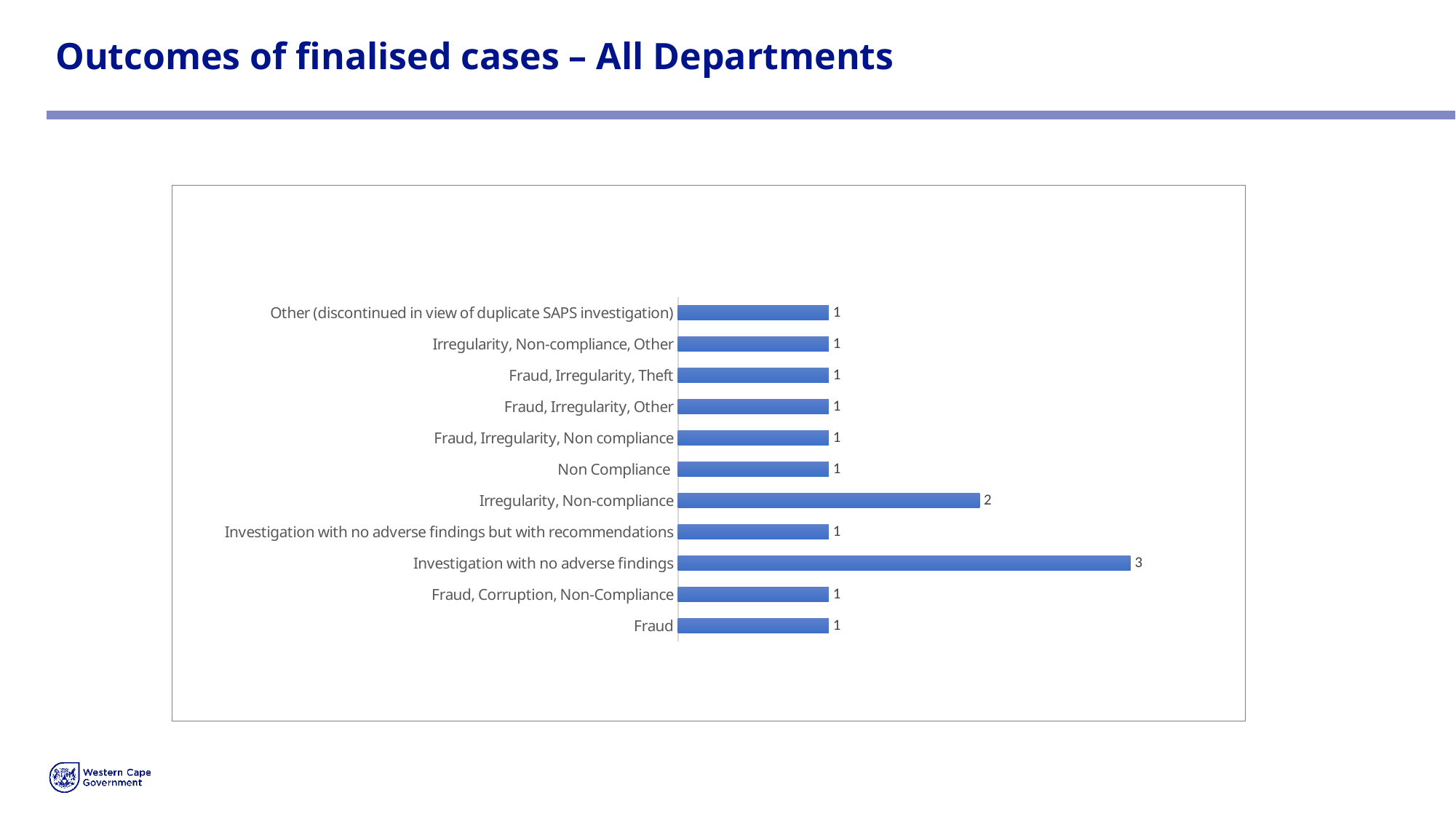
What is the value for Investigation with no adverse findings? 3 What is the title of the slide? Outcomes of finalised cases – All Departments How many categories are shown in the chart? 11 Which category has the highest value? Investigation with no adverse findings What is the total of all the values shown in the chart? 14 What is the value for Irregularity, Non-compliance? 2 What is the value for Other (discontinued in view of duplicate SAPS investigation)? 1 What kind of chart is shown on the slide? Bar chart Which is larger, the value for Irregularity, Non-compliance or the value for Non Compliance? Irregularity, Non-compliance What is the value for Fraud, Corruption, Non-Compliance? 1 What is the difference between the values for Irregularity, Non-compliance and Fraud? 1 What is the difference between the values for Investigation with no adverse findings and Irregularity, Non-compliance? 1